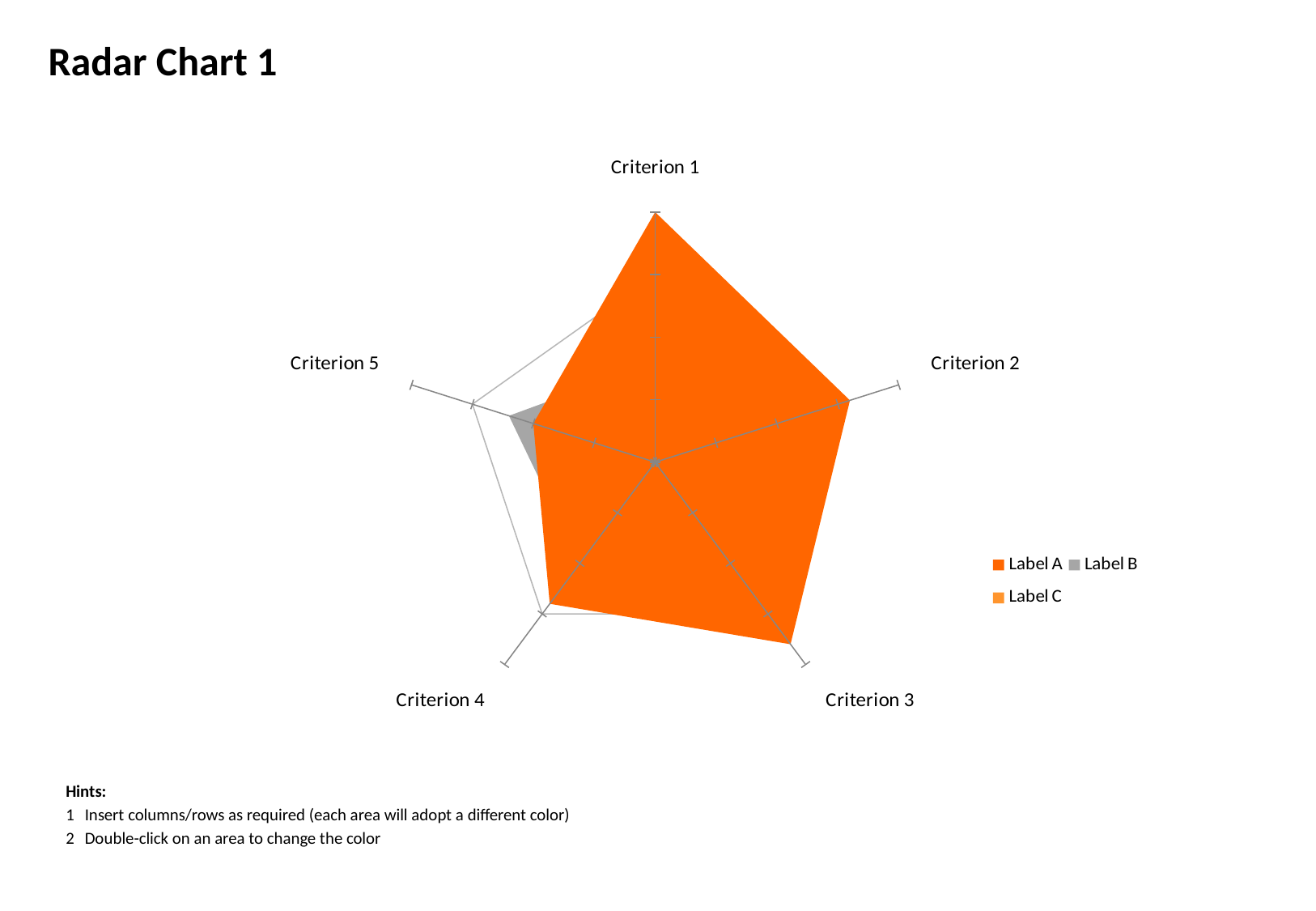
Which series is shown in dark orange? Label A Which criterion label appears at the top of the radar chart? Criterion 1 What is the title of the chart? Radar Chart 1 How many series does the legend list? 3 For Label A, which criterion has the lowest value? Criterion 5 What kind of chart is shown on the slide? Radar chart For Label A, which is larger: the value at Criterion 3 or the value at Criterion 4? Criterion 3 For Label A, is the value at Criterion 1 larger or smaller than the value at Criterion 5? larger How many criteria (axes) does the radar chart have? 5